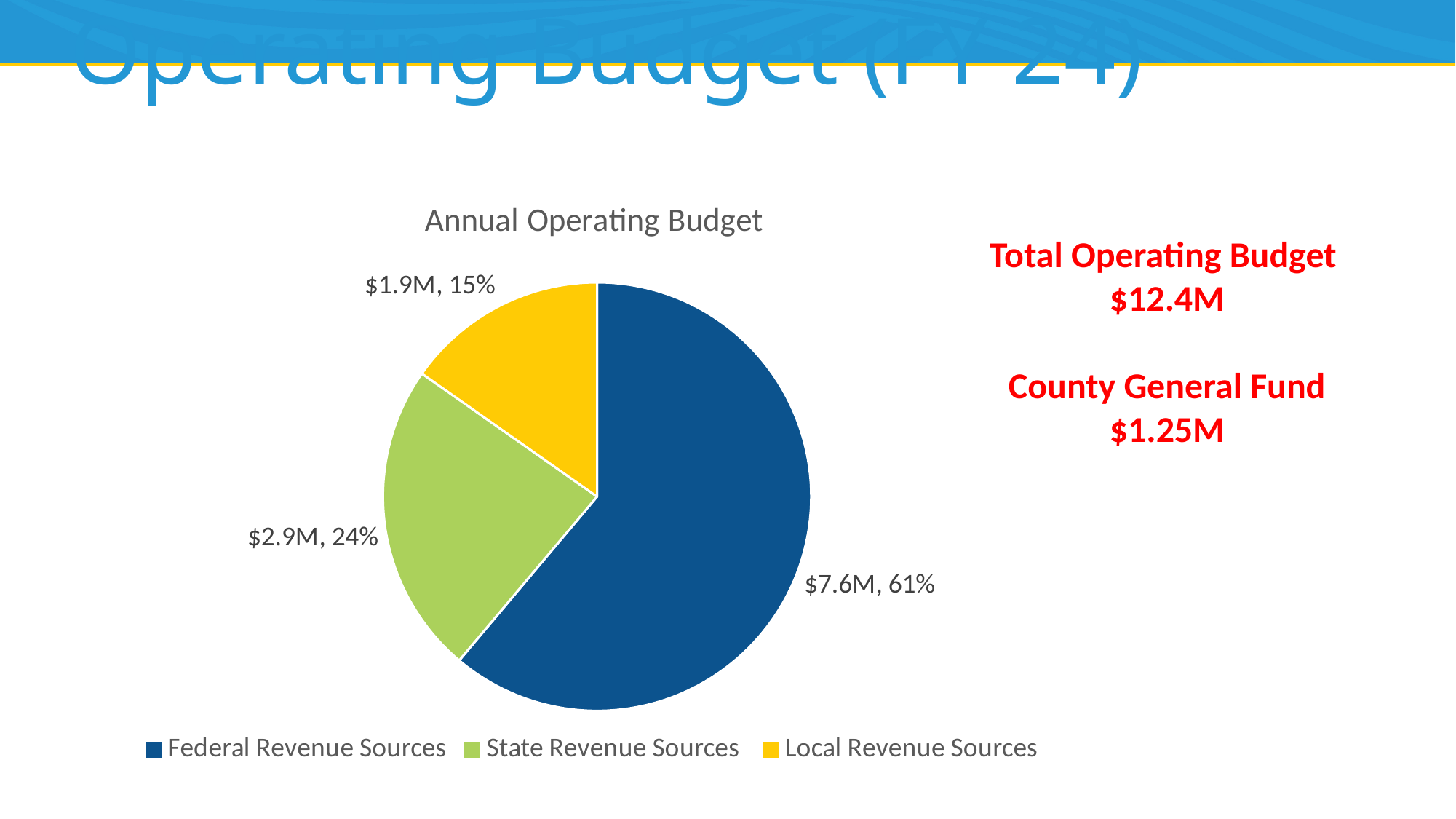
Which revenue source is the largest slice of the pie? Federal Revenue Sources How many slices does the pie chart have? 3 What is the value shown for Federal Revenue Sources? $7.6M What is the title of the chart? Annual Operating Budget What share of the pie does Local Revenue Sources represent? 15% How many entries does the legend list? 3 Which revenue source is the smallest slice of the pie? Local Revenue Sources What is the value shown for State Revenue Sources? $2.9M What type of chart is shown on the slide? Pie chart What is the value shown for Local Revenue Sources? $1.9M What share of the pie does Federal Revenue Sources represent? 61% Which is larger, State Revenue Sources or Local Revenue Sources? State Revenue Sources